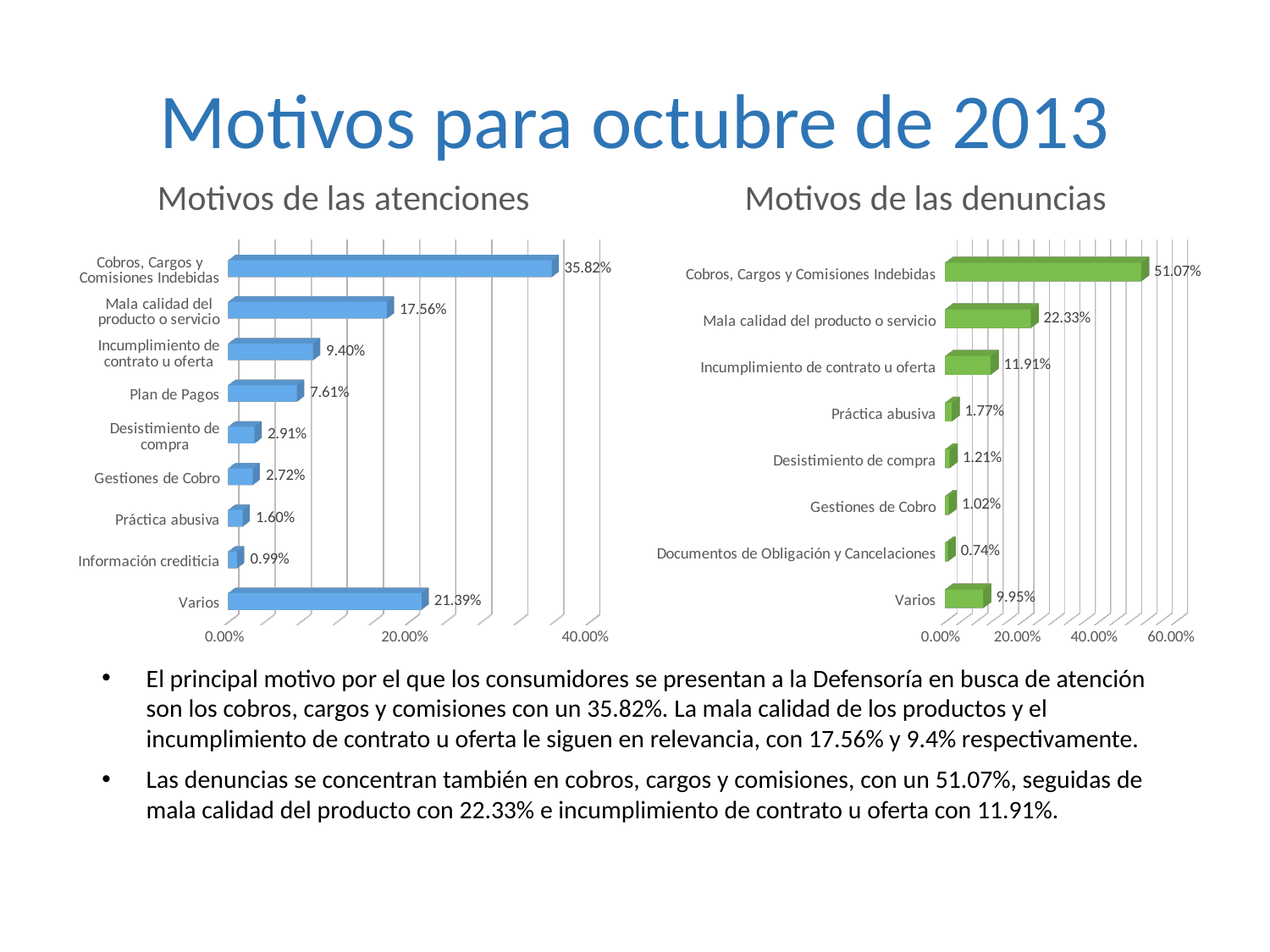
In the 'Motivos de las atenciones' chart, which category has the lowest value? Información crediticia How many categories are shown in the 'Motivos de las atenciones' chart? 9 In the 'Motivos de las denuncias' chart, what is the difference between Mala calidad del producto o servicio and Varios? 12.38% How many categories are shown in the 'Motivos de las denuncias' chart? 8 In the 'Motivos de las denuncias' chart, what is the value for Incumplimiento de contrato u oferta? 11.91% In the 'Motivos de las denuncias' chart, which category has the highest value? Cobros, Cargos y Comisiones Indebidas In the 'Motivos de las atenciones' chart, what is the value for Plan de Pagos? 7.61% In the 'Motivos de las atenciones' chart, what is the difference between Cobros, Cargos y Comisiones Indebidas and Mala calidad del producto o servicio? 18.26% In the 'Motivos de las atenciones' chart, what is the value for Cobros, Cargos y Comisiones Indebidas? 35.82% In the 'Motivos de las atenciones' chart, which is larger: Varios or Mala calidad del producto o servicio? Varios In the 'Motivos de las denuncias' chart, which category has the lowest value? Documentos de Obligación y Cancelaciones What type of chart is 'Motivos de las denuncias'? Bar chart